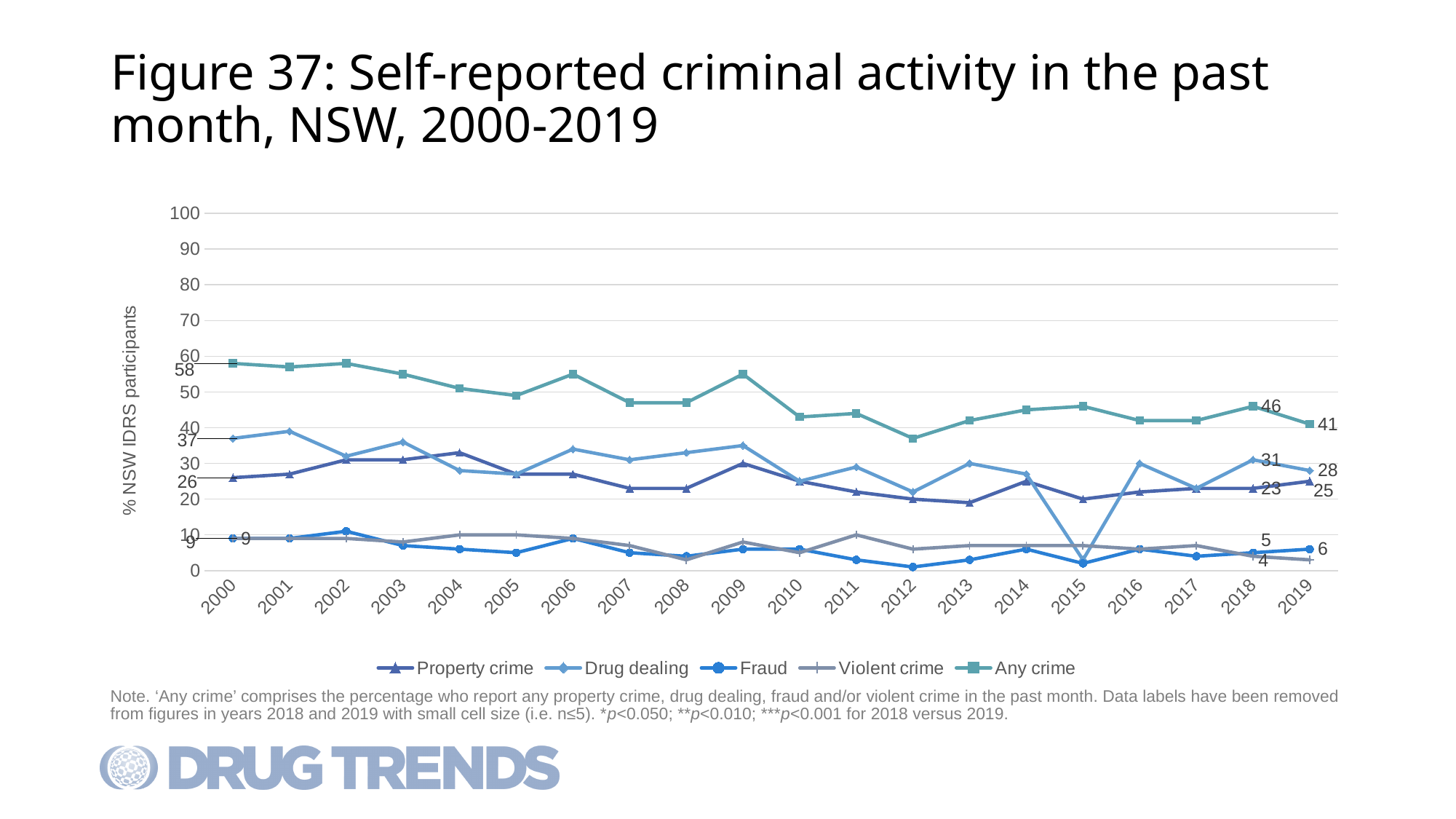
Is the value for Any crime in 2012 greater or less than 40? less What is the value for Drug dealing in 2019? 28 By how much did the Any crime value fall from 2000 to 2019? 17 Which series has the highest value in 2019? Any crime What is the value for Property crime in 2019? 25 In 2019, which is larger: Drug dealing or Property crime? Drug dealing What is the value for Any crime in 2000? 58 What kind of chart is shown on the slide? Line chart What is the value for Any crime in 2019? 41 How many series does the legend list? 5 How many years are plotted along the x axis? 20 What is the value for Fraud in 2019? 6